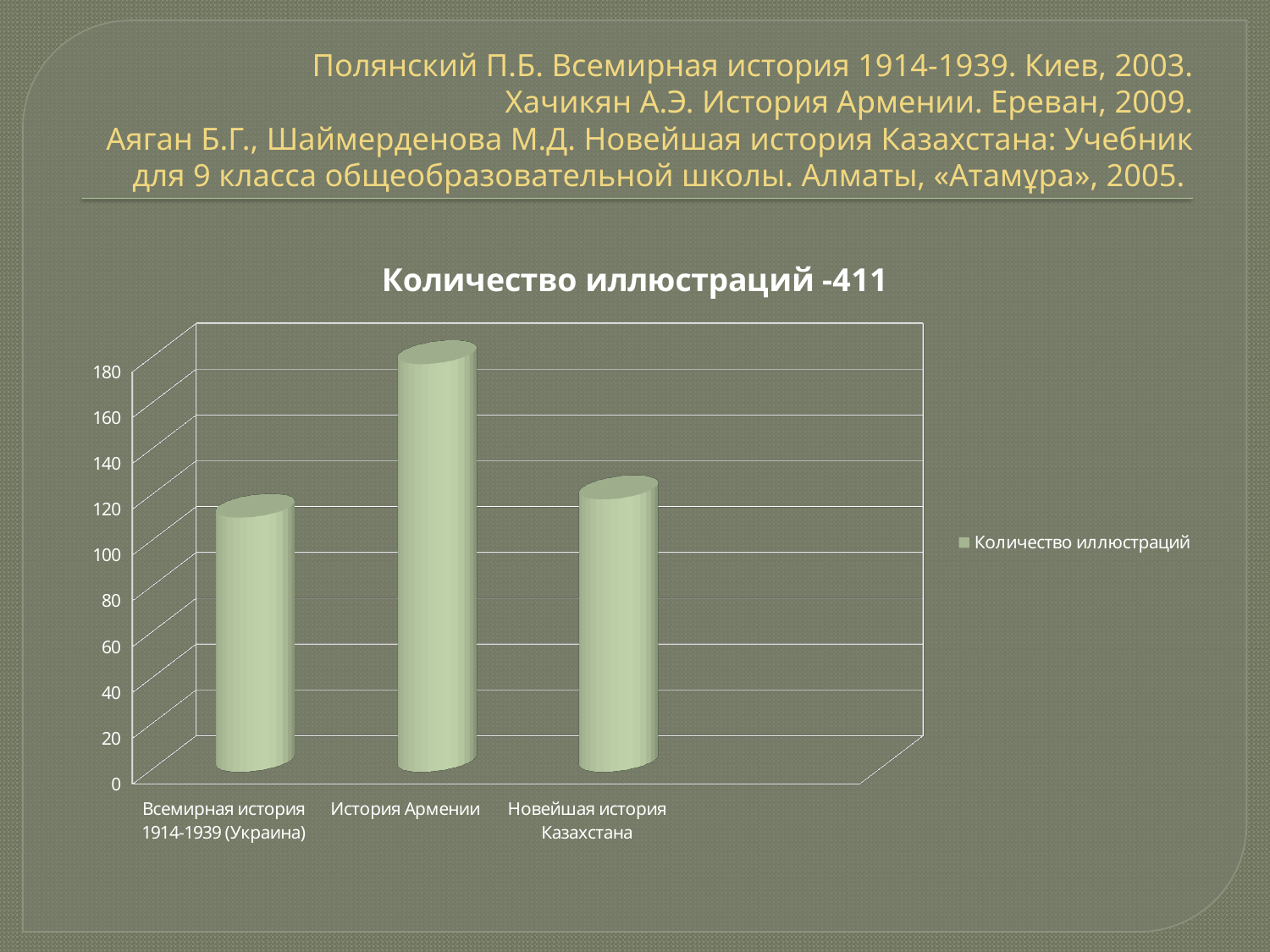
How many categories are shown on the x axis of the chart? 3 Which is larger: the value for Новейшая история Казахстана or the value for Всемирная история 1914-1939 (Украина)? Новейшая история Казахстана Which category has the highest number of illustrations? История Армении How many series does the chart legend list? 1 What type of chart is shown on the slide? bar chart Is the value for Всемирная история 1914-1939 (Украина) greater or less than 140? less What is the name of the series in the chart legend? Количество иллюстраций What is the title of the chart? Количество иллюстраций -411 Is the value for Новейшая история Казахстана greater or less than 100? greater Which is larger: the value for История Армении or the value for Новейшая история Казахстана? История Армении Is the value for История Армении greater or less than 160? greater Which category has the lowest number of illustrations? Всемирная история 1914-1939 (Украина)